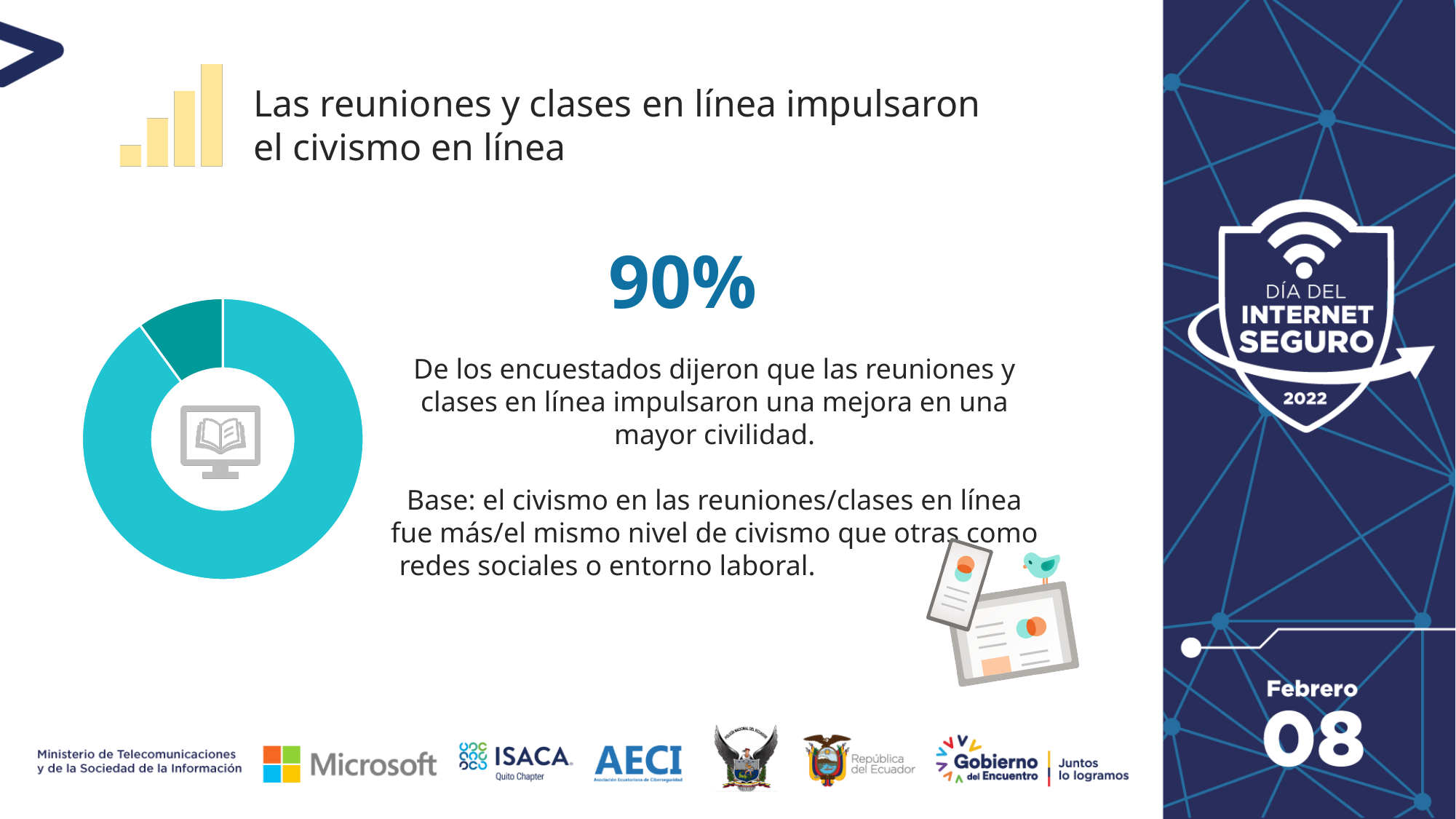
Which slice of the donut chart is larger, the light teal one or the dark teal one? the light teal one What is the title of the slide containing the donut chart? Las reuniones y clases en línea impulsaron el civismo en línea How many slices does the donut chart have? 2 Does the large slice of the donut chart represent more or less than half of the respondents? more What kind of chart is shown on the slide? donut chart What icon is shown in the centre of the donut chart? a monitor with an open book What share of the donut chart does the large light teal slice represent? 90% What percentage of respondents said online meetings and classes drove an improvement in civility? 90%